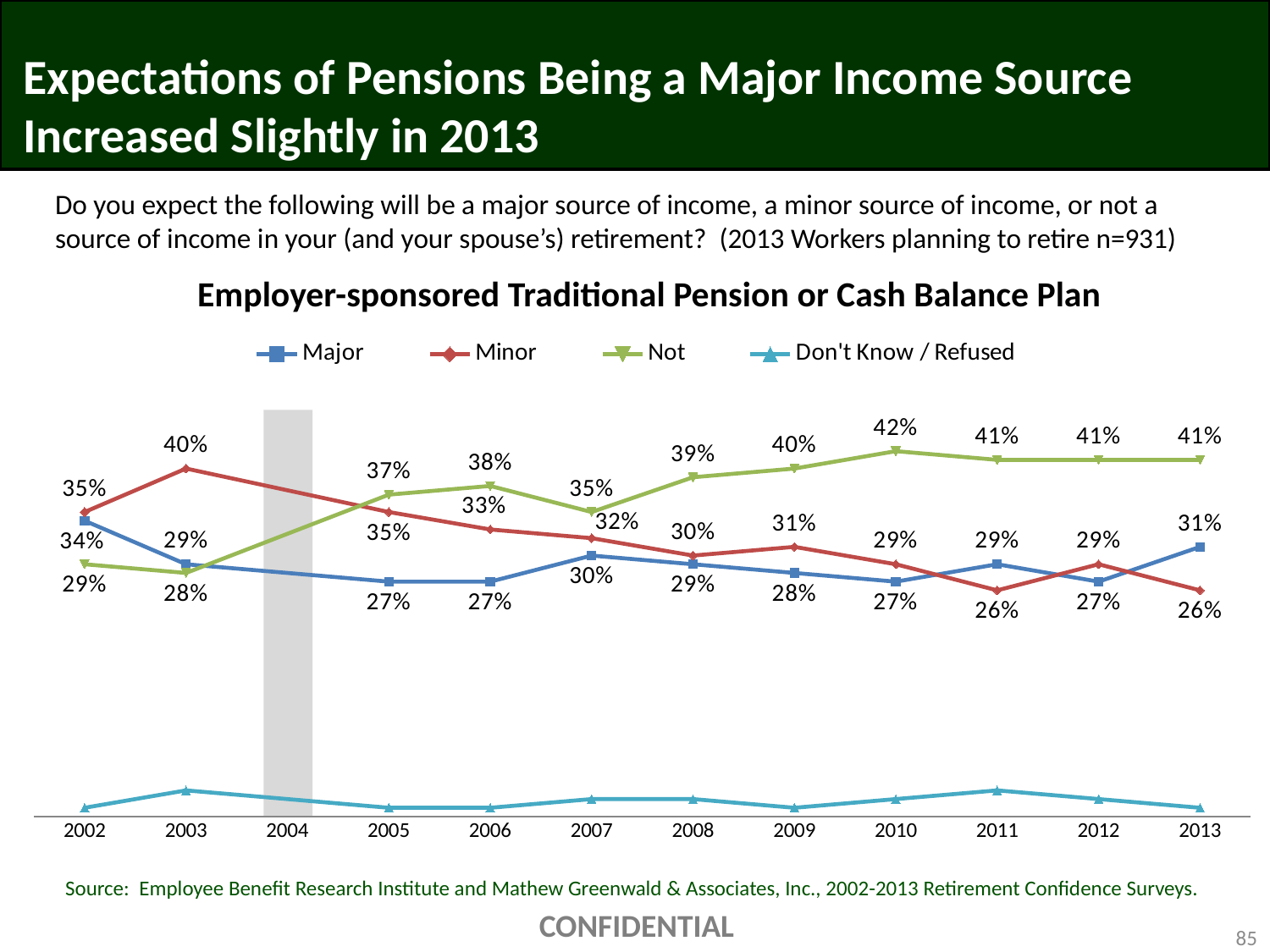
What is the difference between the Not value and the Major value in 2013? 10 percentage points What is the lowest value shown for the Minor series? 26% How many series does the legend list? 4 What is the value for Not in 2010? 42% In which year does the Not series reach its highest value? 2010 How many years are labeled on the x axis? 12 In 2002, which is larger: the value for Major or the value for Not? Major What type of chart is shown on the slide? line chart What is the value for Minor in 2003? 40% What is the title of the chart? Employer-sponsored Traditional Pension or Cash Balance Plan Does the Not series rise or fall from 2002 to 2010? rise What is the value for Major in 2013? 31%